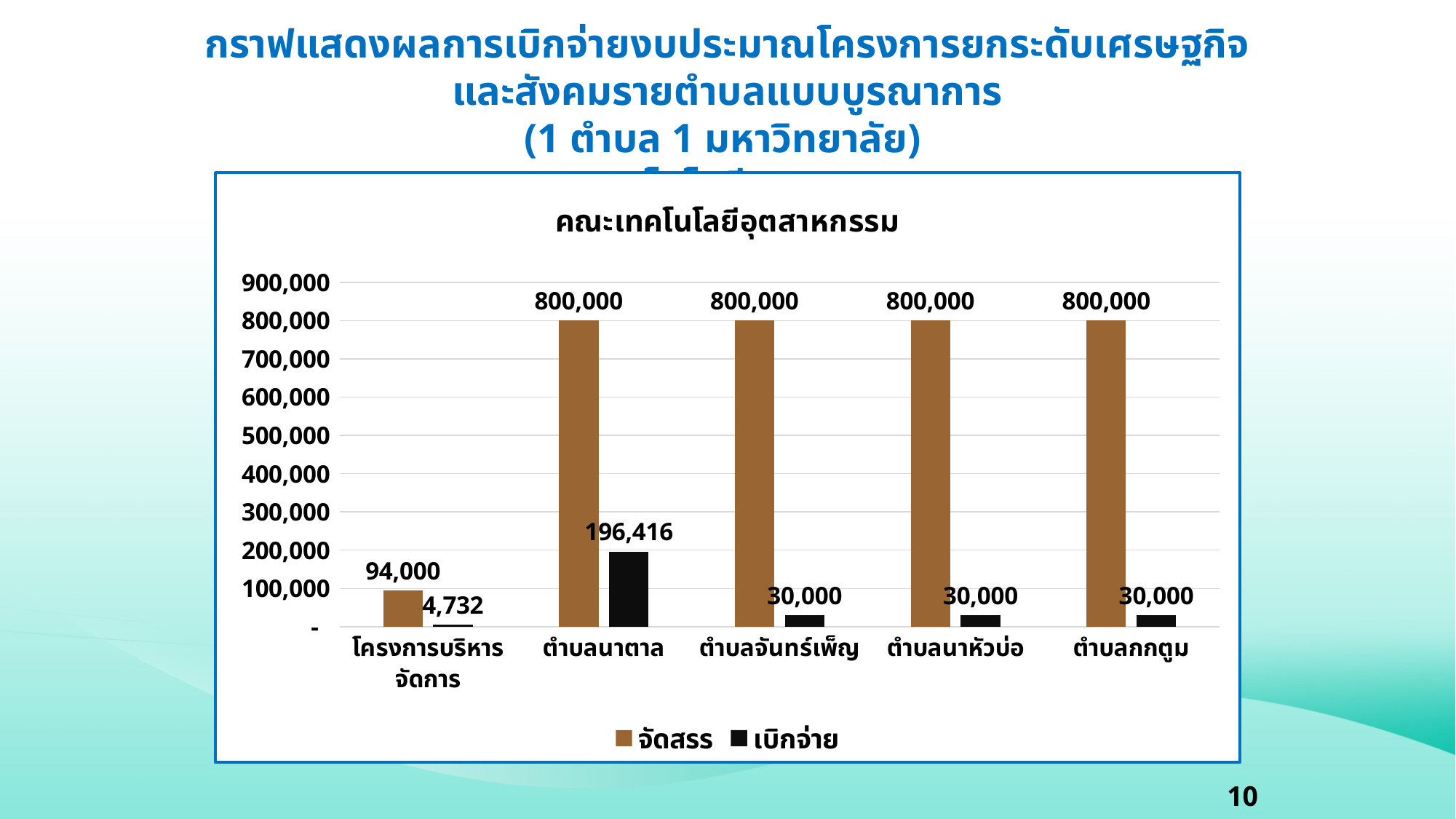
How many categories are shown on the x axis? 5 Which category has the lowest จัดสรร value? โครงการบริหารจัดการ What is the difference between the จัดสรร and เบิกจ่าย values for ตำบลนาตาล? 603,584 What type of chart is shown on the slide? bar chart What is the difference between the จัดสรร and เบิกจ่าย values for ตำบลจันทร์เพ็ญ? 770,000 Which is larger: the เบิกจ่าย value for ตำบลนาตาล or the เบิกจ่าย value for ตำบลนาหัวบ่อ? ตำบลนาตาล What is the เบิกจ่าย value for โครงการบริหารจัดการ? 4,732 What is the เบิกจ่าย value for ตำบลนาตาล? 196,416 Which category has the highest เบิกจ่าย value? ตำบลนาตาล How many series does the legend list? 2 What is the จัดสรร value for ตำบลกกตูม? 800,000 What is the จัดสรร value for โครงการบริหารจัดการ? 94,000